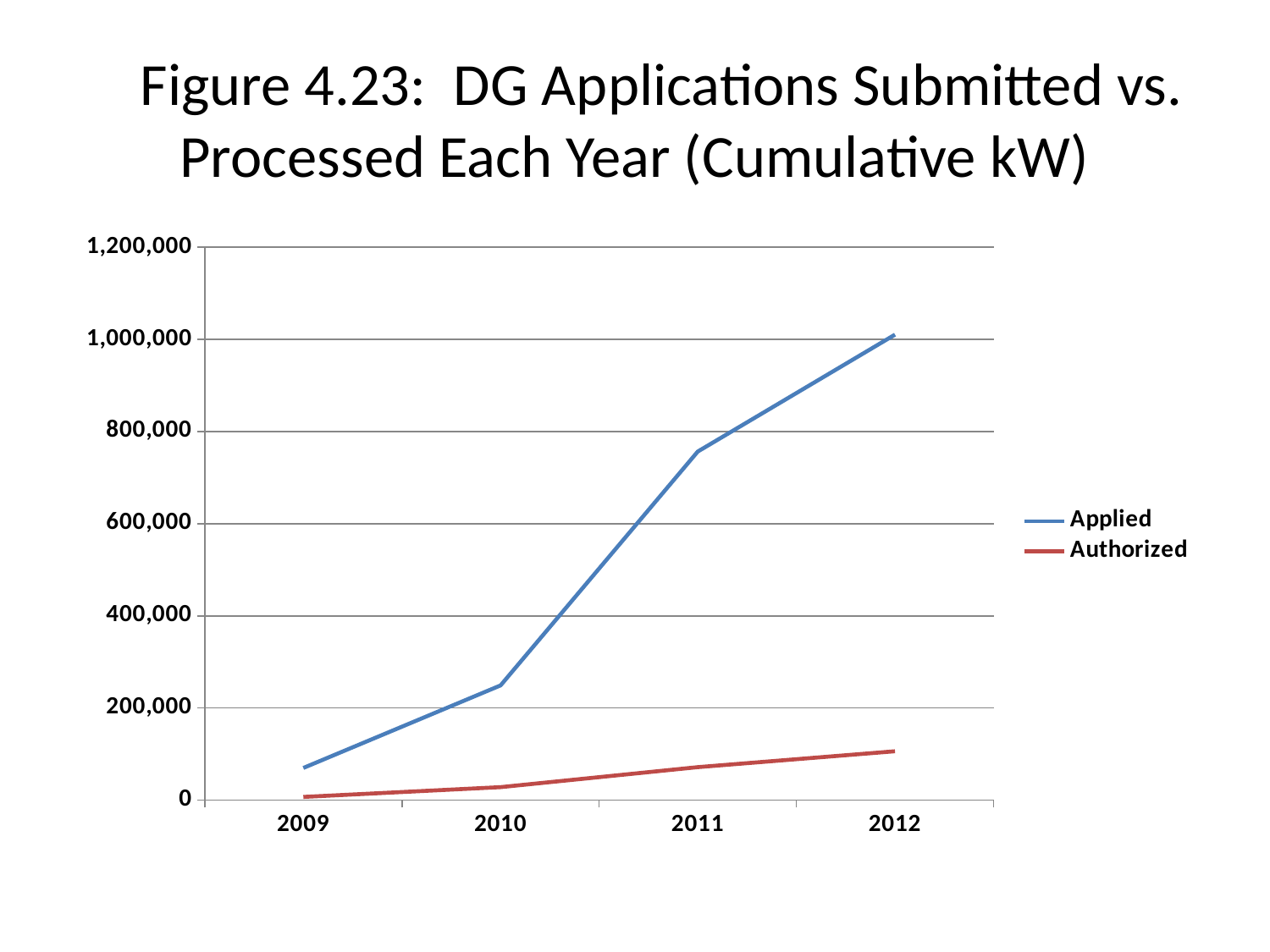
How many years are plotted on the x axis? 4 How many series does the legend list? 2 Does the Applied series rise or fall from 2009 to 2012? rise Is the Authorized value for 2012 greater or less than 200,000? less Which year has the lowest Authorized value? 2009 Is the Applied value for 2010 greater or less than 200,000? greater What colour is the Authorized line? red Is the Applied value for 2011 greater or less than 800,000? less What kind of chart is shown on the slide? line chart Which year has the highest Applied value? 2012 Which series is larger in 2011, Applied or Authorized? Applied